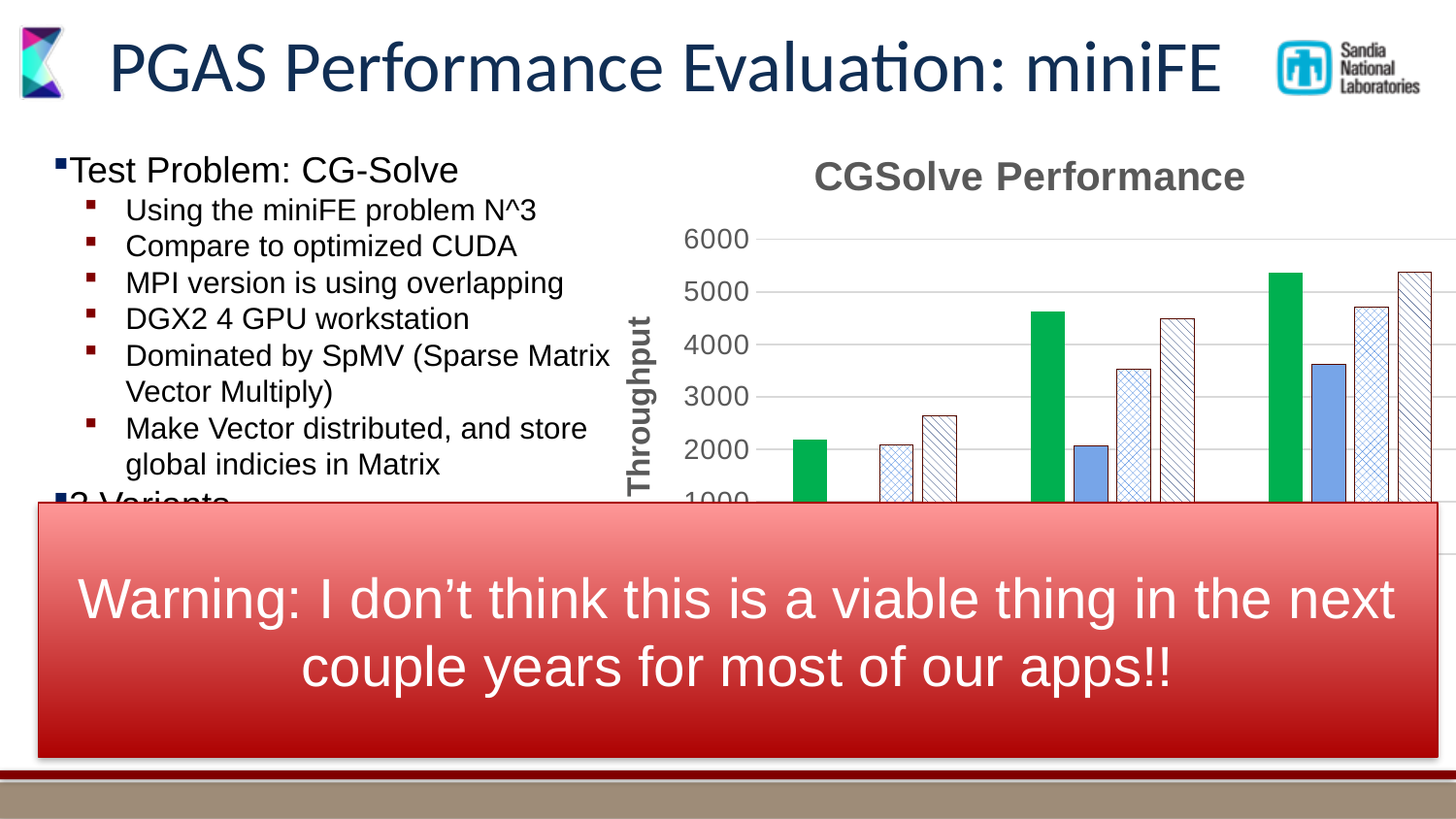
In the CGSolve Performance chart, how many groups of bars are visible? 3 In the CGSolve Performance chart, is the value of the cross-hatched bar in the middle group greater or less than 3000? greater In the CGSolve Performance chart, which is larger in the rightmost group: the solid green bar or the solid blue bar? the solid green bar In the CGSolve Performance chart, is the value of the solid green bar in the rightmost group greater or less than 5000? greater In the CGSolve Performance chart, is the value of the diagonally hatched bar in the leftmost group greater or less than 3000? less In the CGSolve Performance chart, do the solid green bars rise or fall from left to right across the groups? rise What kind of chart is shown on the slide? bar chart What is the label on the vertical axis of the CGSolve Performance chart? Throughput What is the title of the chart on the slide? CGSolve Performance